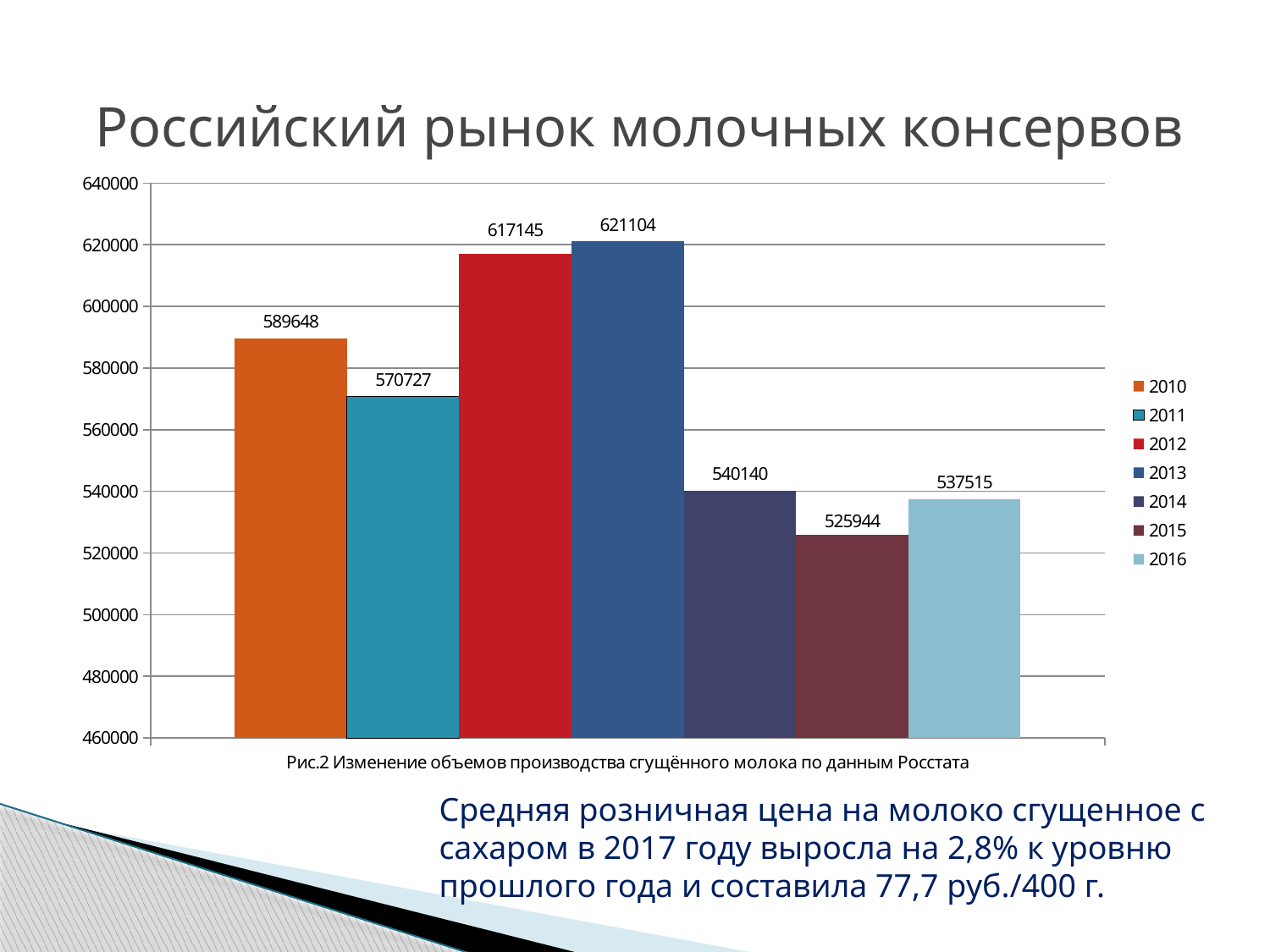
Do the values rise or fall from 2013 to 2015? fall Which is larger, the value for 2014 or the value for 2016? 2014 What is the difference between the values for 2010 and 2011? 18921 How many series does the legend list? 7 Which year has the lowest value? 2015 Which year has the highest value? 2013 What is the difference between the values for 2013 and 2012? 3959 What is the value for 2013? 621104 What is the value for 2015? 525944 What is the value for 2010? 589648 Is the value for 2011 greater or less than 560000? greater What kind of chart is shown on the slide? bar chart